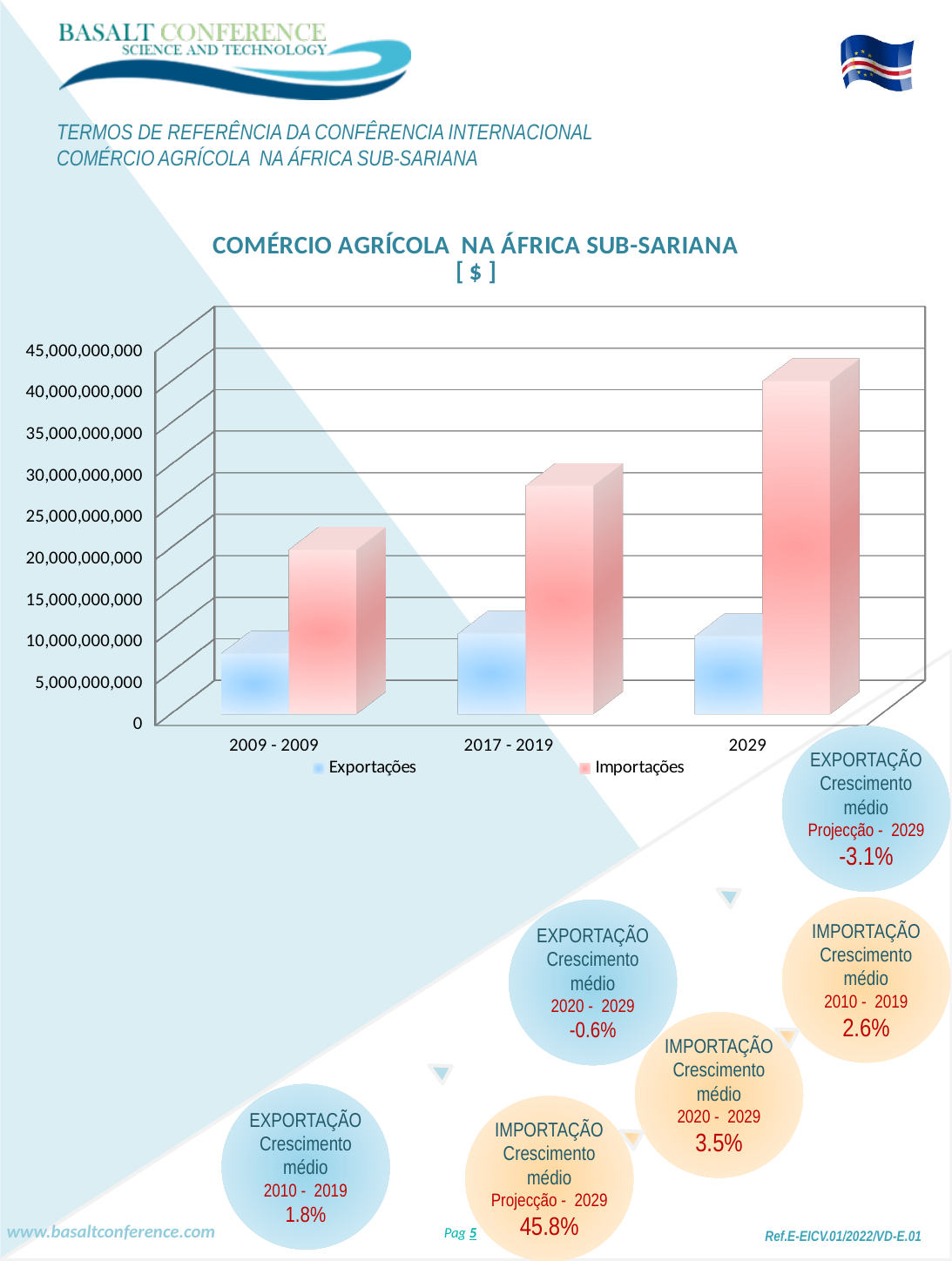
What kind of chart is shown on the slide? bar chart In which category is the Importações value lowest? 2009 - 2009 Which series is shown in red in the chart? Importações What is the title of the chart? COMÉRCIO AGRÍCOLA NA ÁFRICA SUB-SARIANA [ $ ] How many series does the chart legend list? 2 For 2029, which is larger, Exportações or Importações? Importações How many categories are shown on the x axis of the chart? 3 Is the Importações value for 2029 greater or less than 35,000,000,000? greater In which category is the Importações value highest? 2029 Do the Importações values rise or fall from 2009 - 2009 to 2029? rise Is the Exportações value for 2009 - 2009 greater or less than 10,000,000,000? less Is the Importações value for 2009 - 2009 greater or less than 25,000,000,000? less